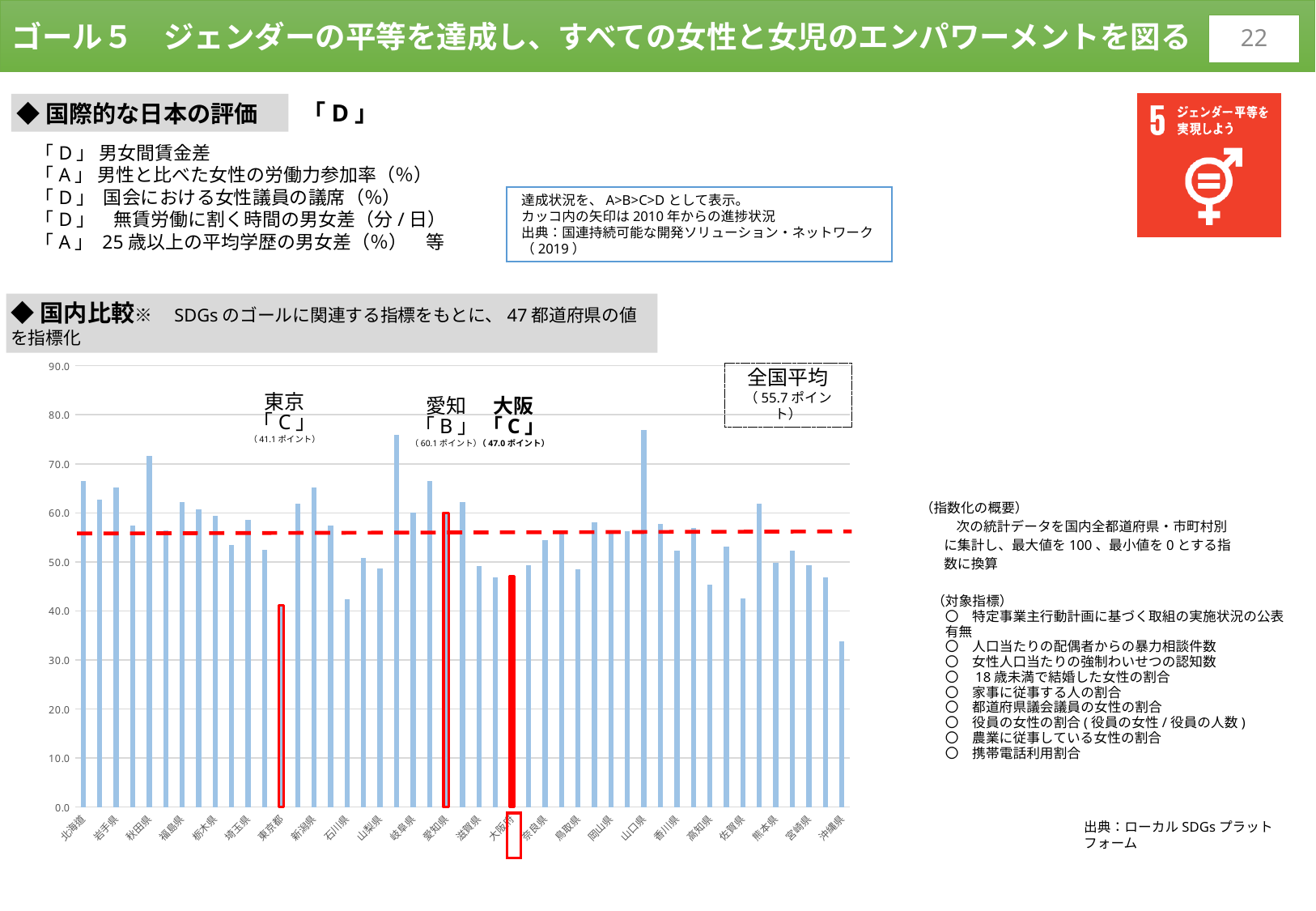
Is the value for 北海道 in the 国内比較 chart greater or less than 60.0? greater Is the value for 沖縄県 in the 国内比較 chart greater or less than 40.0? less Which has the larger value in the 国内比較 chart, 東京 or 大阪? 大阪 Which prefecture has the lowest value in the 国内比較 chart? 沖縄県 What is the value for 愛知 in the 国内比較 bar chart? 60.1 ポイント How much higher is the value for 愛知 than the value for 大阪 in the 国内比較 chart? 13.1 ポイント What grade is shown for 愛知 above the 国内比較 chart? B What kind of chart is used for the 国内比較 section? bar chart What is the value for 大阪 in the 国内比較 bar chart? 47.0 ポイント What is the value for 東京 in the 国内比較 bar chart? 41.1 ポイント Is the value for 山口県 in the 国内比較 chart greater or less than 70.0? greater What is the 全国平均 value shown on the 国内比較 chart? 55.7 ポイント